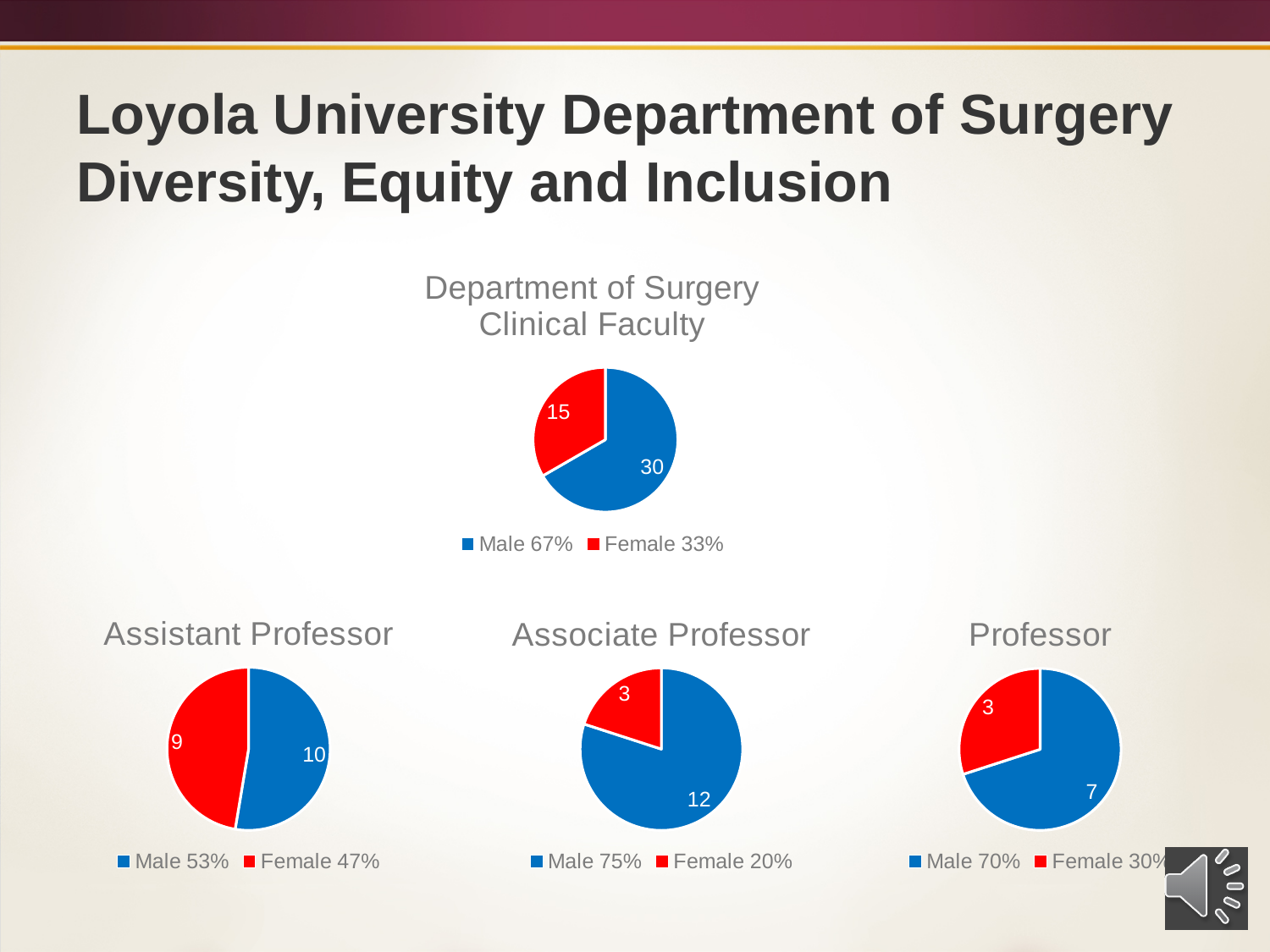
In the Department of Surgery Clinical Faculty chart, what is the difference between the Male and Female values? 15 In the Assistant Professor chart, what is the value for Female? 9 In the Department of Surgery Clinical Faculty chart, what is the value for Female? 15 In the Professor chart, what is the value for Male? 7 In the Professor chart, what share of the pie does Female represent according to the legend? 30% In the Associate Professor chart, what is the difference between the Male and Female values? 9 In the Associate Professor chart, what is the value for Male? 12 In the Department of Surgery Clinical Faculty chart, what share of the pie does Female represent according to the legend? 33% In the Assistant Professor chart, what share of the pie does Male represent according to the legend? 53% In the Assistant Professor chart, which slice is larger, Male or Female? Male What type of chart is the Professor chart? Pie chart In the Department of Surgery Clinical Faculty chart, what is the value for Male? 30